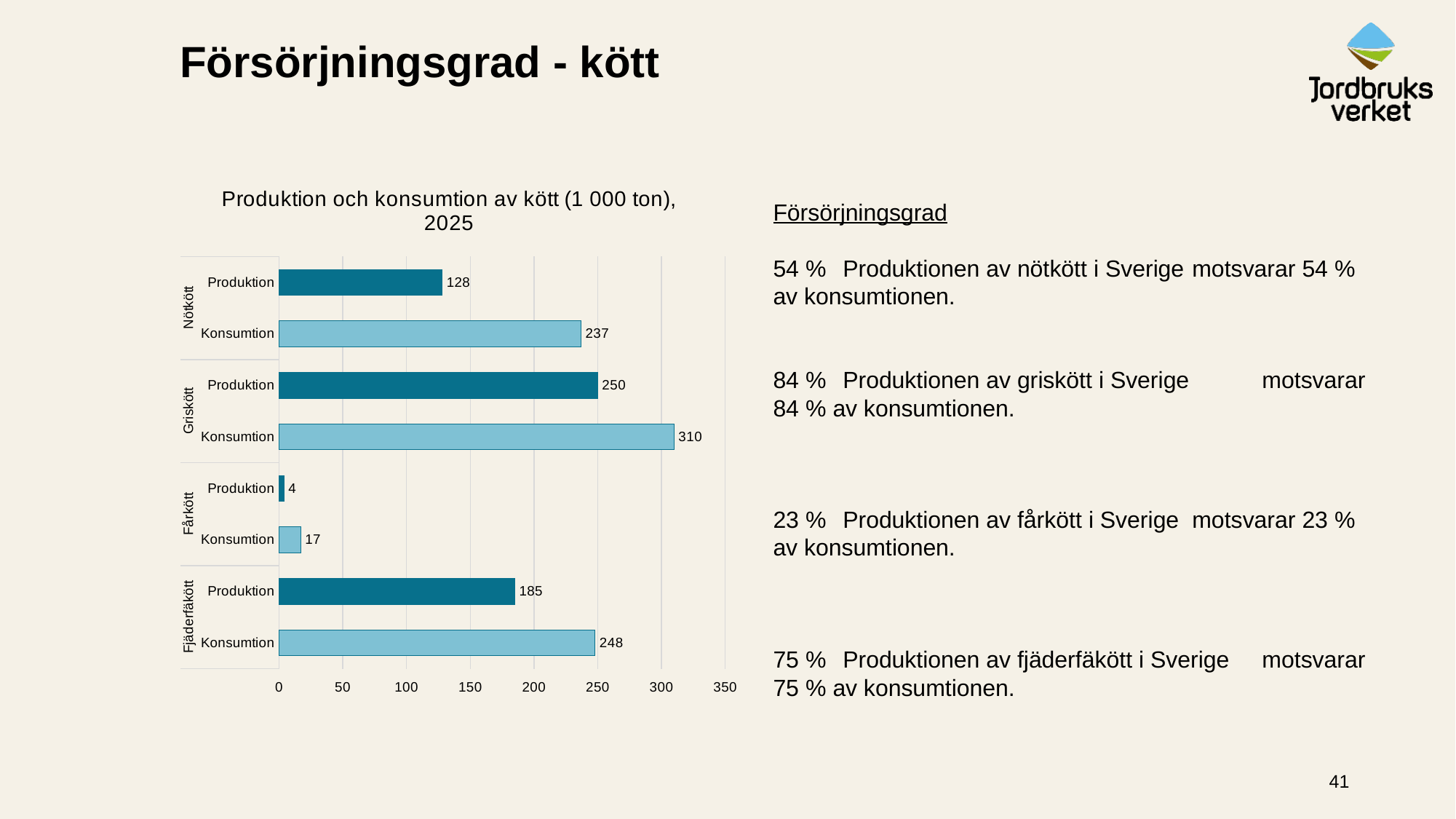
Which bar has the highest value in the chart? Konsumtion of Griskött What is the difference between Konsumtion and Produktion for Nötkött? 109 What is the value for Produktion of Nötkött? 128 What is the value for Konsumtion of Griskött? 310 What is the value for Produktion of Fårkött? 4 Which bar has the lowest value in the chart? Produktion of Fårkött What is the title of the chart? Produktion och konsumtion av kött (1 000 ton), 2025 What is the value for Konsumtion of Fjäderfäkött? 248 What is the difference between Konsumtion and Produktion for Fjäderfäkött? 63 Which is larger: Produktion of Griskött or Konsumtion of Nötkött? Produktion of Griskött How many bars are plotted in the chart? 8 What kind of chart is shown on the slide? Bar chart